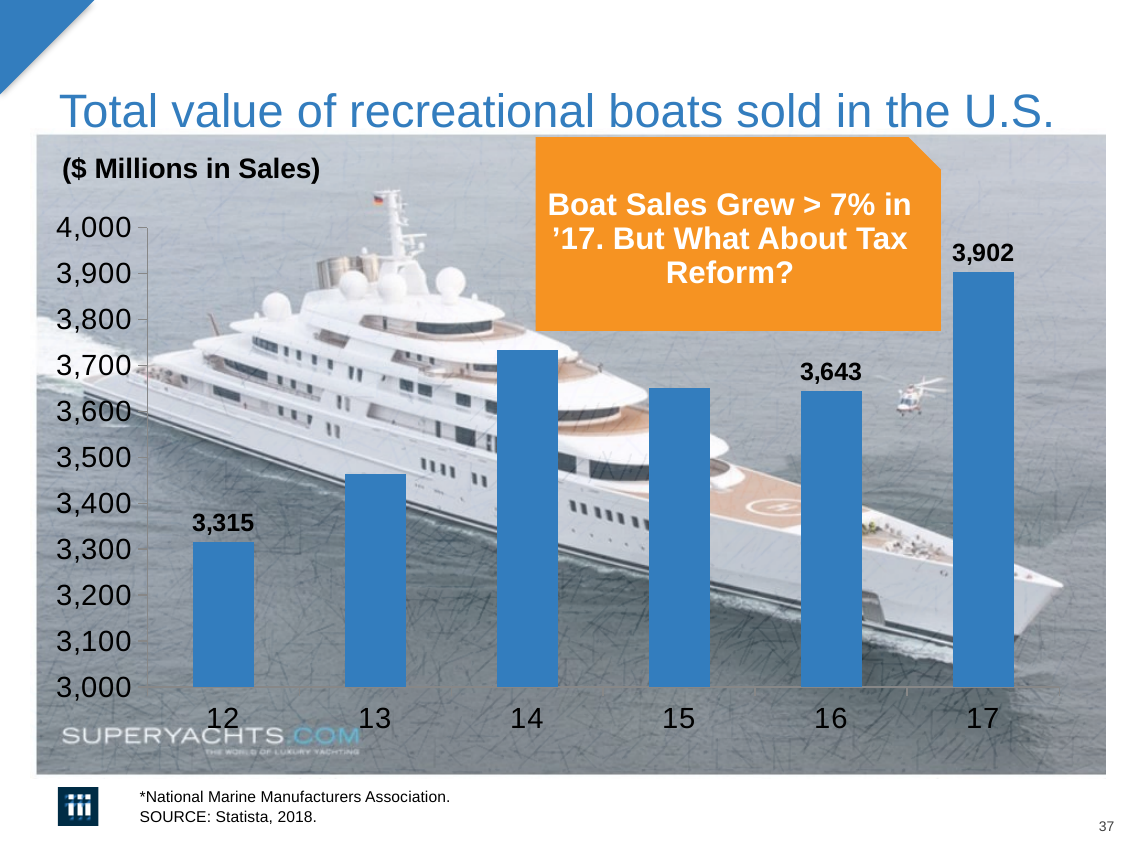
What is the value shown for 16? 3,643 Is the value for 13 greater or less than 3,500? less How many years are shown on the x axis? 6 What is the difference between the values for 17 and 12? 587 What is the total value of recreational boats sold in the U.S. in 12? 3,315 What kind of chart is shown on the slide? bar chart Is the value for 14 greater or less than 3,700? greater What is the difference between the values for 17 and 16? 259 Which year has the highest value? 17 What is the value shown for 17? 3,902 Which is larger, the value for 16 or the value for 12? 16 Which year has the lowest value? 12